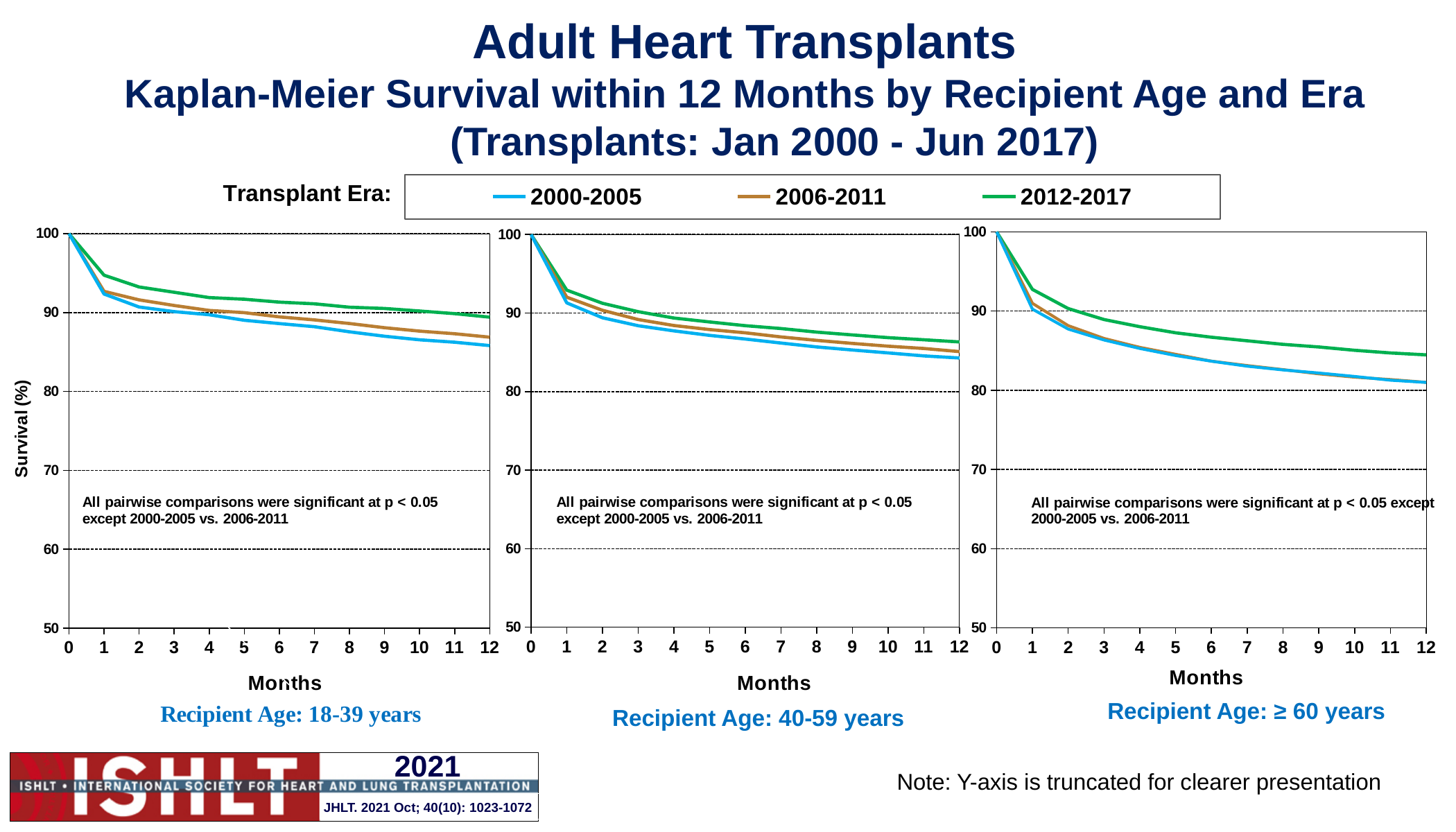
In the 'Recipient Age: 40-59 years' chart, does survival rise or fall as months increase? fall In the 'Recipient Age: 40-59 years' chart, which era has the lowest survival at 12 months? 2000-2005 In the 'Recipient Age: ≥ 60 years' chart, is the 2000-2005 survival at 12 months greater or less than 90? less What kind of chart is used in the 'Recipient Age: 18-39 years' panel? line chart How many transplant eras does the legend list? 3 In the 'Recipient Age: ≥ 60 years' chart, which is higher at 12 months: 2012-2017 or 2000-2005? 2012-2017 In the 'Recipient Age: ≥ 60 years' chart, what is the survival value for every era at month 0? 100 In the 'Recipient Age: 18-39 years' chart, is the 2012-2017 survival at 12 months greater or less than 80? greater In the 'Recipient Age: 40-59 years' chart, is the 2000-2005 survival at 12 months greater or less than 90? less How many months does the x axis of each chart span, from 0 to what maximum? 12 Which colour represents the 2006-2011 era in the legend? brown In the 'Recipient Age: 18-39 years' chart, which era has the highest survival at 12 months? 2012-2017